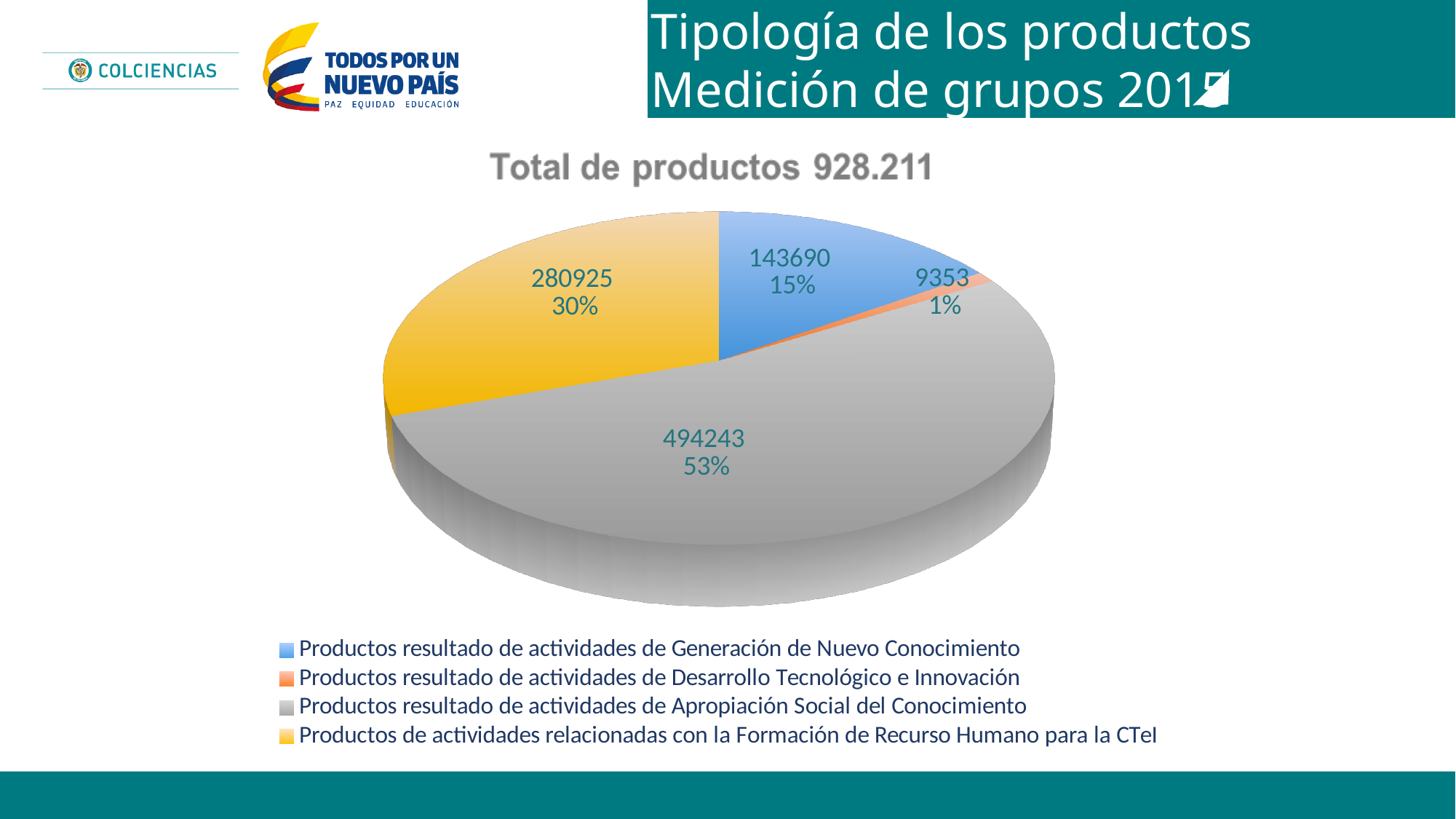
Which category has the largest slice? Productos resultado de actividades de Apropiación Social del Conocimiento What percentage share does Productos de actividades relacionadas con la Formación de Recurso Humano para la CTeI have? 30% What is the value for Productos resultado de actividades de Apropiación Social del Conocimiento? 494243 What is the difference between the values for Apropiación Social del Conocimiento and Formación de Recurso Humano para la CTeI? 213318 Which category has the smallest slice? Productos resultado de actividades de Desarrollo Tecnológico e Innovación Which is larger, the value for Generación de Nuevo Conocimiento or the value for Formación de Recurso Humano para la CTeI? Formación de Recurso Humano para la CTeI What is the value for Productos resultado de actividades de Generación de Nuevo Conocimiento? 143690 How many entries does the legend list? 4 What kind of chart is shown on the slide? pie chart What is the value for Productos resultado de actividades de Desarrollo Tecnológico e Innovación? 9353 How many slices does the pie chart have? 4 What is the title of the chart? Total de productos 928.211